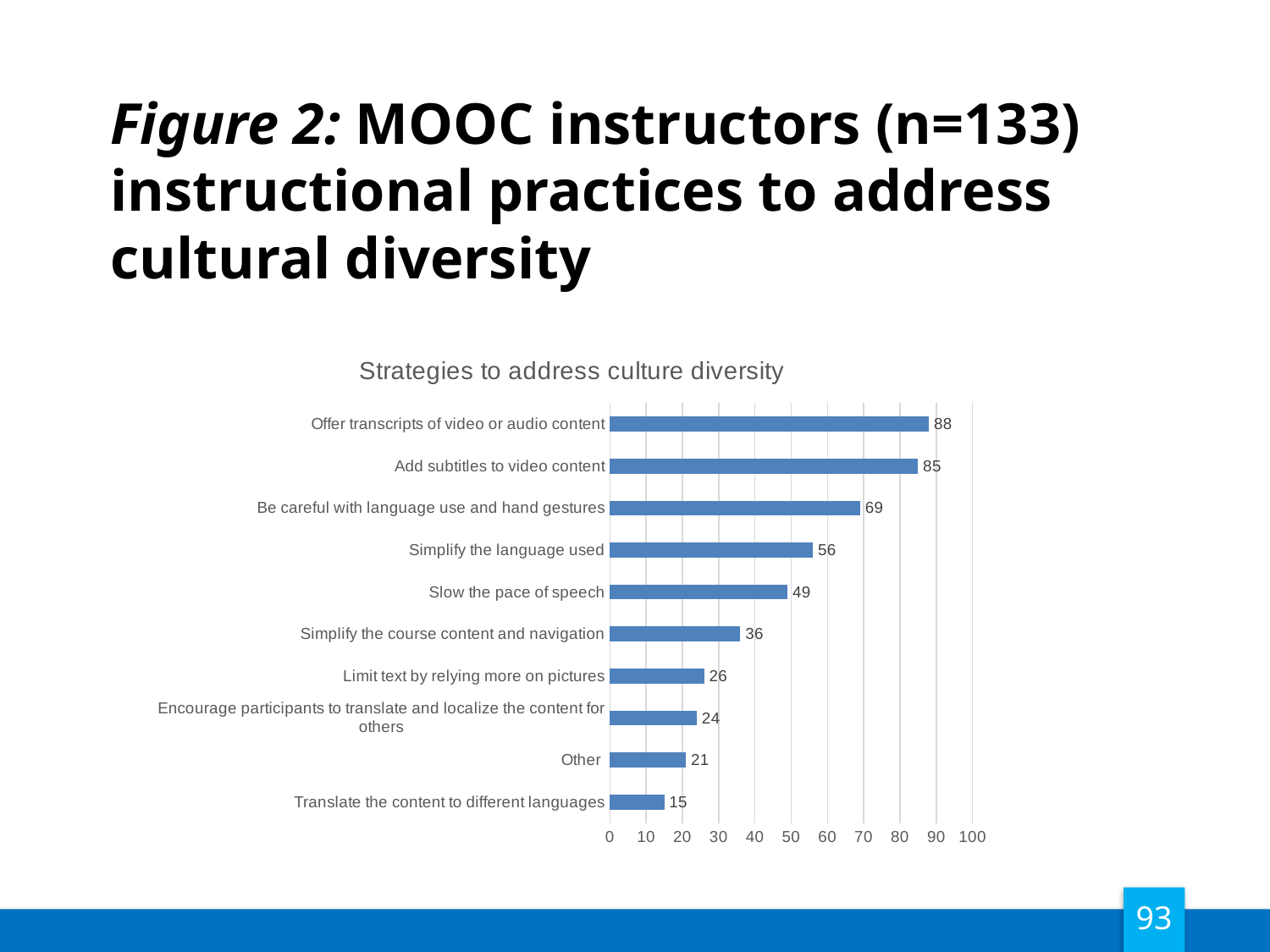
Which is larger: "Limit text by relying more on pictures" or "Encourage participants to translate and localize the content for others"? Limit text by relying more on pictures What is the value for "Slow the pace of speech"? 49 What is the value for "Add subtitles to video content"? 85 Which strategy has the highest value? Offer transcripts of video or audio content How many strategies are shown in the chart? 10 What kind of chart is shown on the slide? bar chart What is the difference between "Be careful with language use and hand gestures" and "Simplify the language used"? 13 Which strategy has the lowest value? Translate the content to different languages What is the maximum value shown on the horizontal axis? 100 What is the value for "Other"? 21 What is the title of the chart? Strategies to address culture diversity Is the value for "Simplify the course content and navigation" greater or less than 40? less